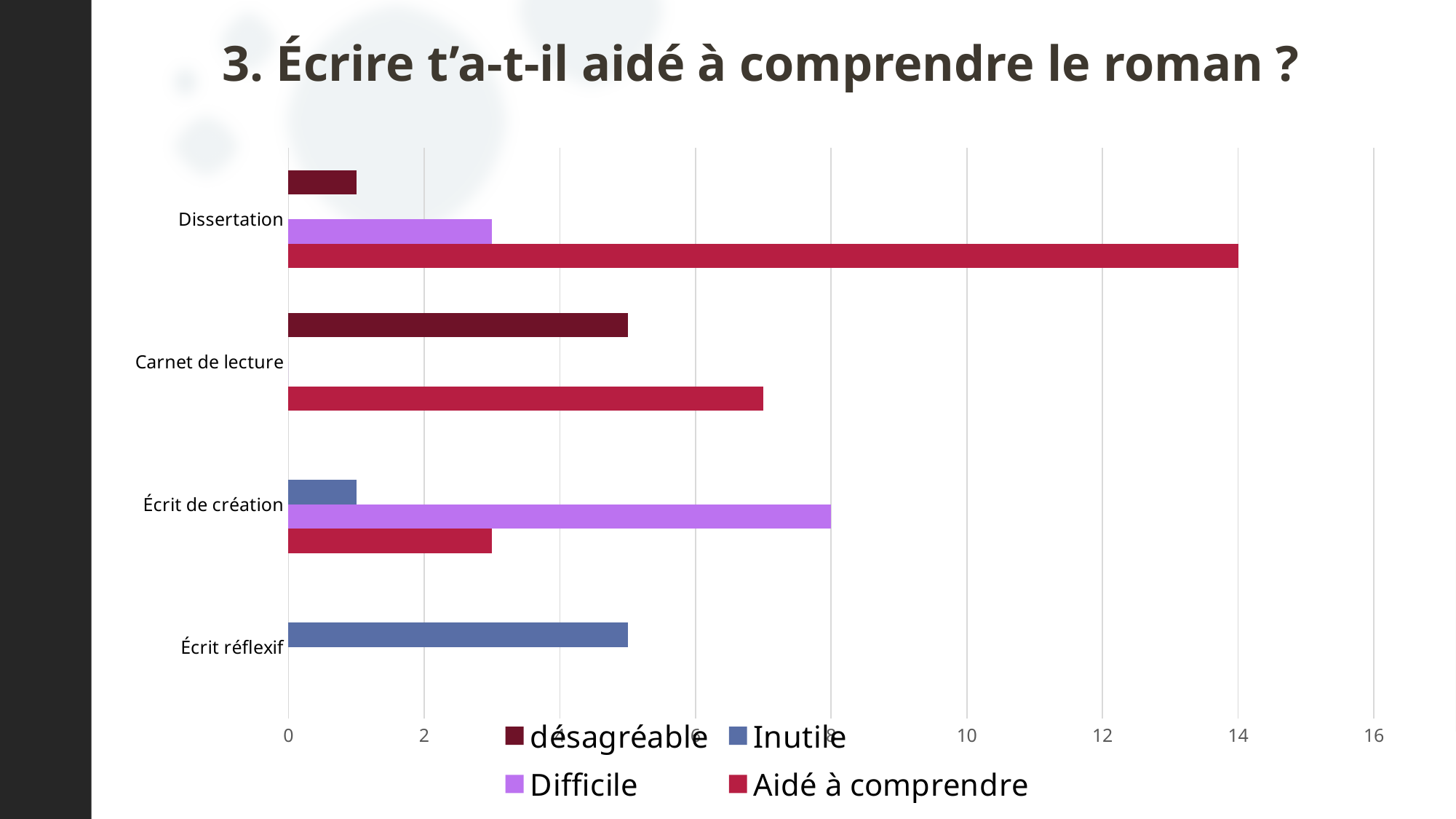
For Écrit de création, which is larger: 'Difficile' or 'Aidé à comprendre'? Difficile What kind of chart is shown on the slide? bar chart Is the 'désagréable' value for Dissertation greater or less than 2? less Which category has the lowest 'Aidé à comprendre' value among those with a bar? Écrit de création How many categories are shown on the vertical axis? 4 What is the value of 'Aidé à comprendre' for Dissertation? 14 Which category has the highest 'Aidé à comprendre' value? Dissertation Is the 'Aidé à comprendre' value for Carnet de lecture greater or less than 6? greater Is the 'Inutile' value for Écrit réflexif greater or less than 4? greater How many series does the legend list? 4 Which series is shown in blue in the legend? Inutile What is the value of 'Difficile' for Écrit de création? 8